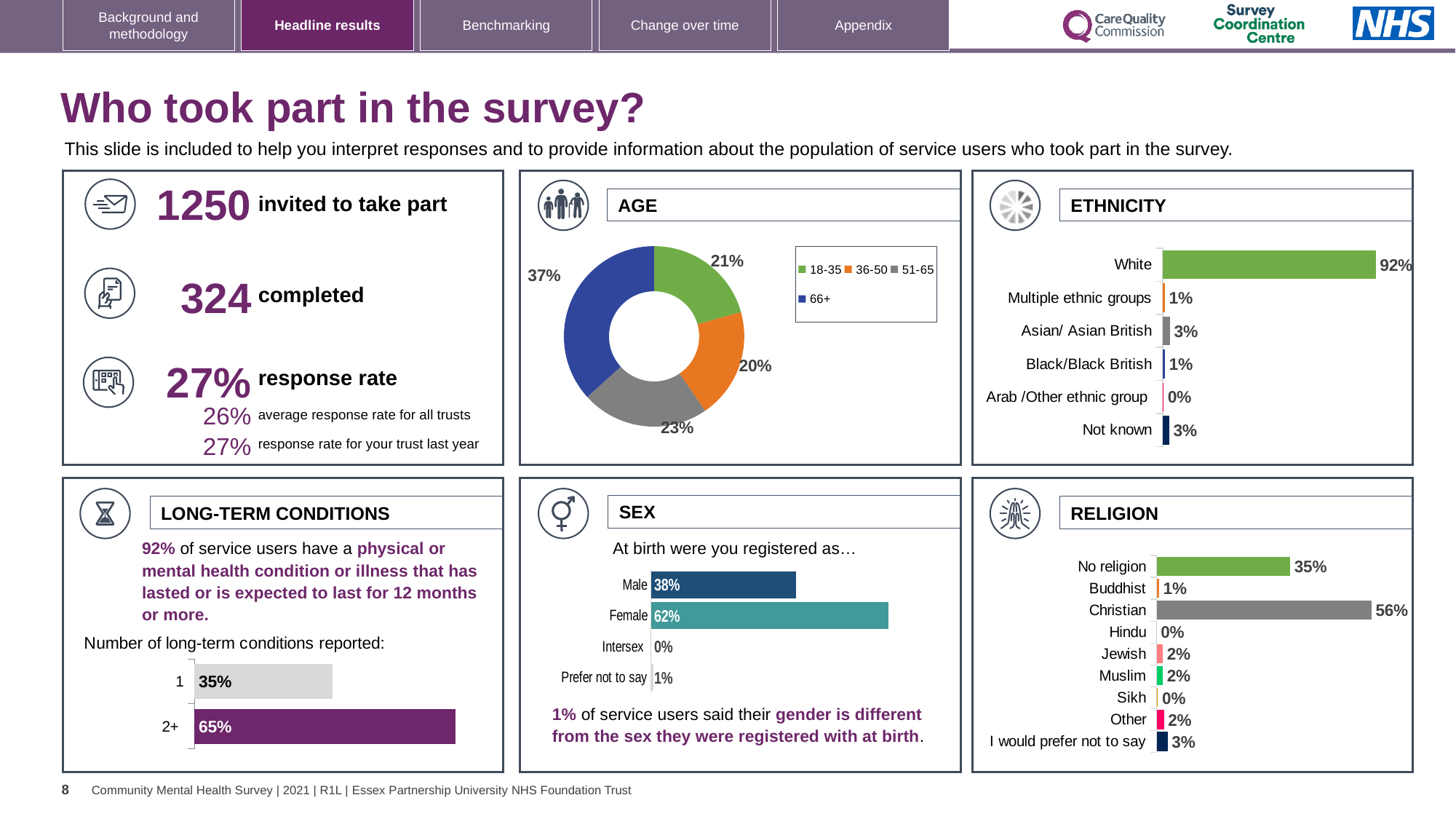
What kind of chart is the AGE chart? Donut chart In the AGE chart, what percentage of respondents were aged 66+? 37% How many categories are shown in the RELIGION chart? 9 In the AGE chart, which age group has the smallest share? 36-50 In the SEX chart, which is larger, the value for Male or the value for Female? Female In the ETHNICITY chart, which category has the highest value? White In the RELIGION chart, what is the value for Christian? 56% In the SEX chart, what is the value for Prefer not to say? 1% In the ETHNICITY chart, what is the value for Asian/ Asian British? 3% How many entries does the legend of the AGE chart list? 4 How many categories are shown in the ETHNICITY chart? 6 In the LONG-TERM CONDITIONS chart, what is the difference between the value for 2+ and the value for 1? 30%